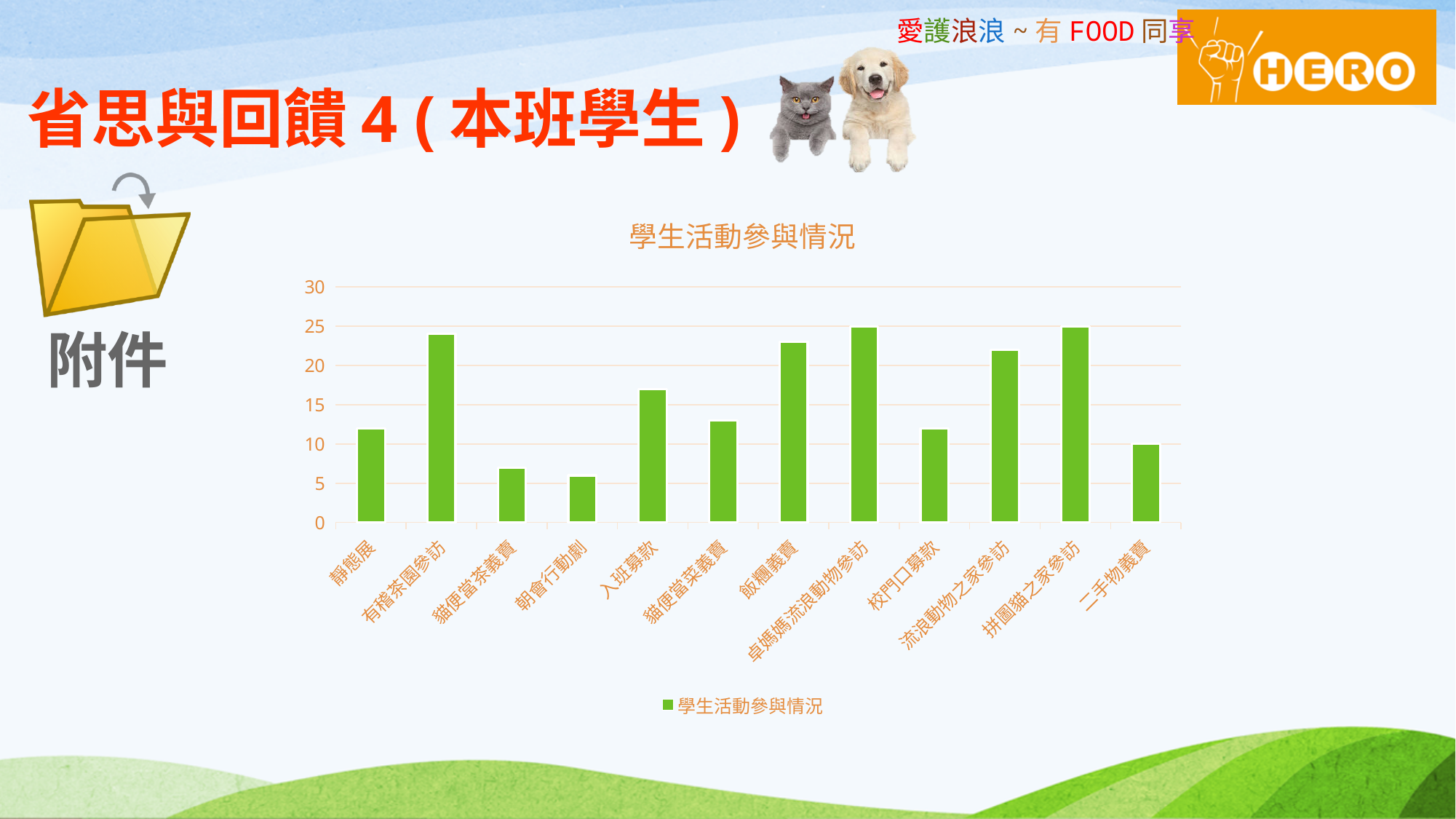
How many categories are shown on the x axis of the chart? 12 How many series does the legend list? 1 Is the value for 流浪動物之家參訪 greater or less than 20? greater What type of chart is shown on the slide? bar chart Is the value for 入班募款 greater or less than 15? greater What is the title of the chart? 學生活動參與情況 Is the value for 貓便當茶義賣 greater or less than 10? less Which has a larger value, 飯糰義賣 or 校門口募款? 飯糰義賣 What is the legend entry shown below the chart? 學生活動參與情況